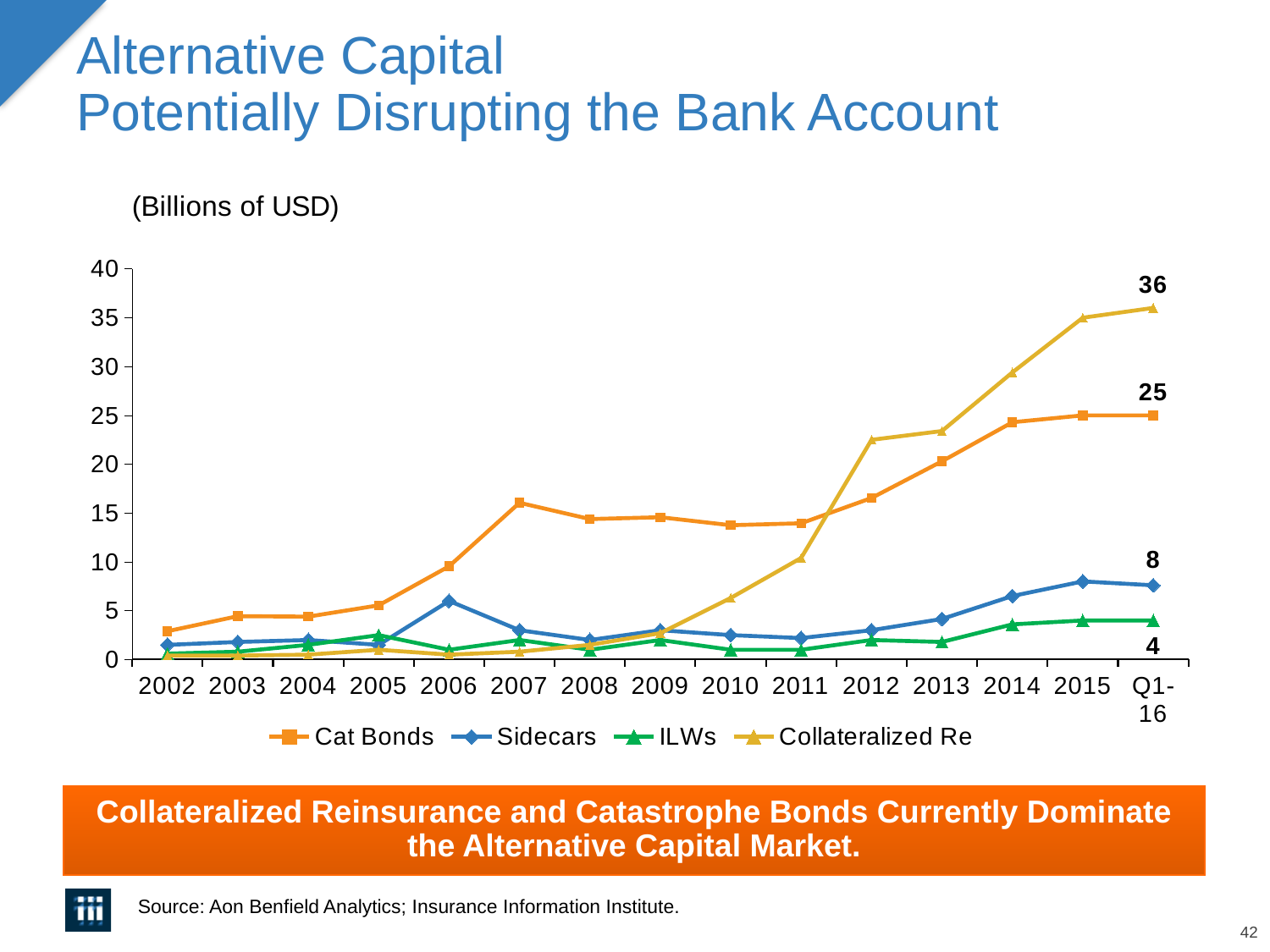
Is the value for Collateralized Re in 2012 greater or less than 20? greater What kind of chart is shown on the slide? Line chart What is the value for ILWs at Q1-16? 4 What is the value for Collateralized Re at Q1-16? 36 What is the difference between the Collateralized Re and Cat Bonds values at Q1-16? 11 What is the value for Sidecars at Q1-16? 8 Which series has the lowest value at Q1-16? ILWs How many series does the legend list? 4 Which series has the highest value at Q1-16? Collateralized Re What is the value for Cat Bonds at Q1-16? 25 At Q1-16, which is larger: Sidecars or ILWs? Sidecars Does the Collateralized Re series generally rise or fall from 2010 to Q1-16? Rise